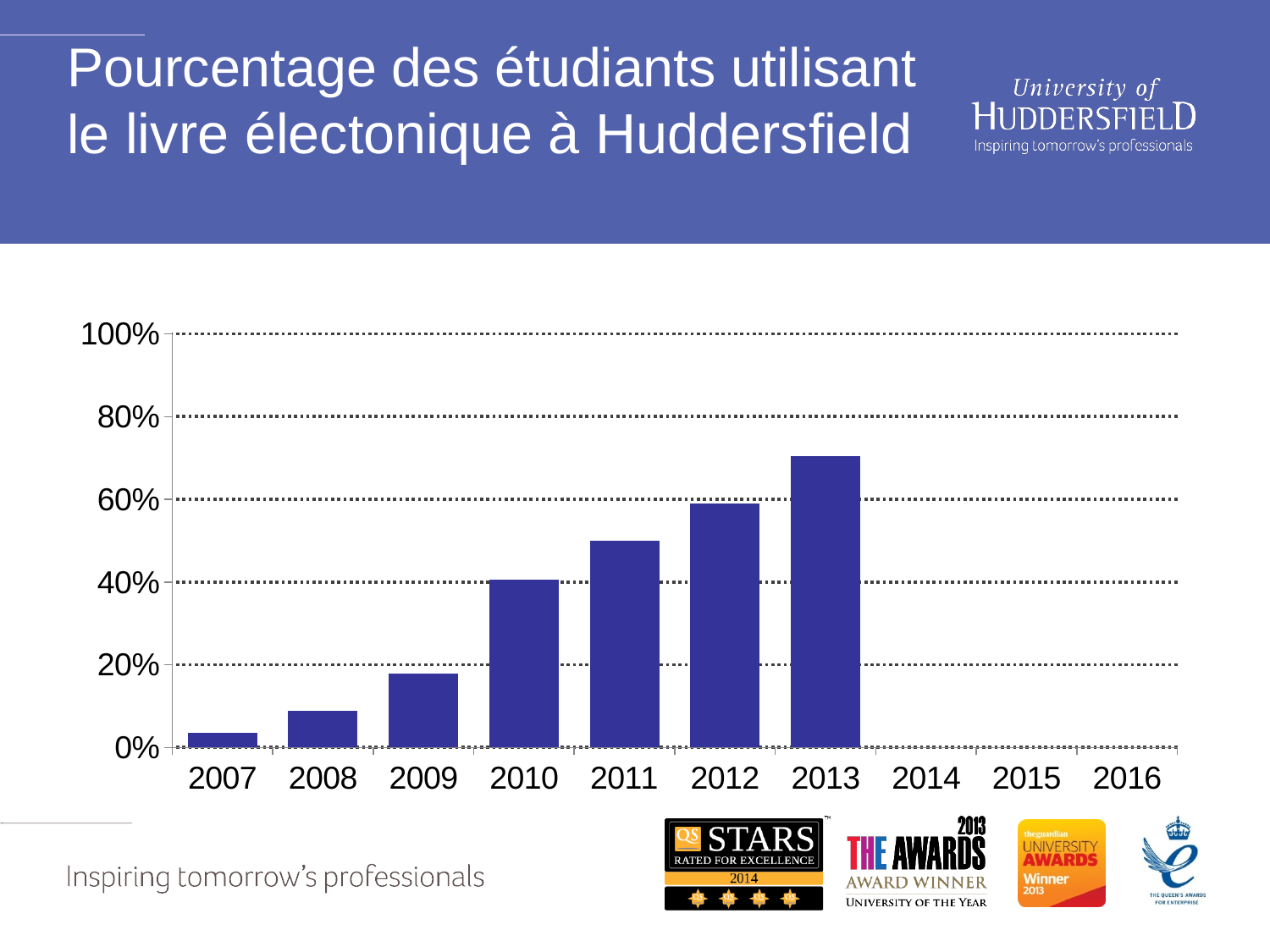
Is the value for 2011 greater or less than 60%? less Is the value for 2008 greater or less than 20%? less Is the value for 2010 greater or less than 60%? less What is the title of the slide containing the chart? Pourcentage des étudiants utilisant le livre électonique à Huddersfield What kind of chart is shown on the slide? bar chart Which year has the highest percentage of students using e-books? 2013 How many bars are plotted on the chart? 7 Do the values rise or fall from 2007 to 2013? rise Which year has the lowest percentage of students using e-books? 2007 Which is larger, the value for 2012 or the value for 2010? 2012